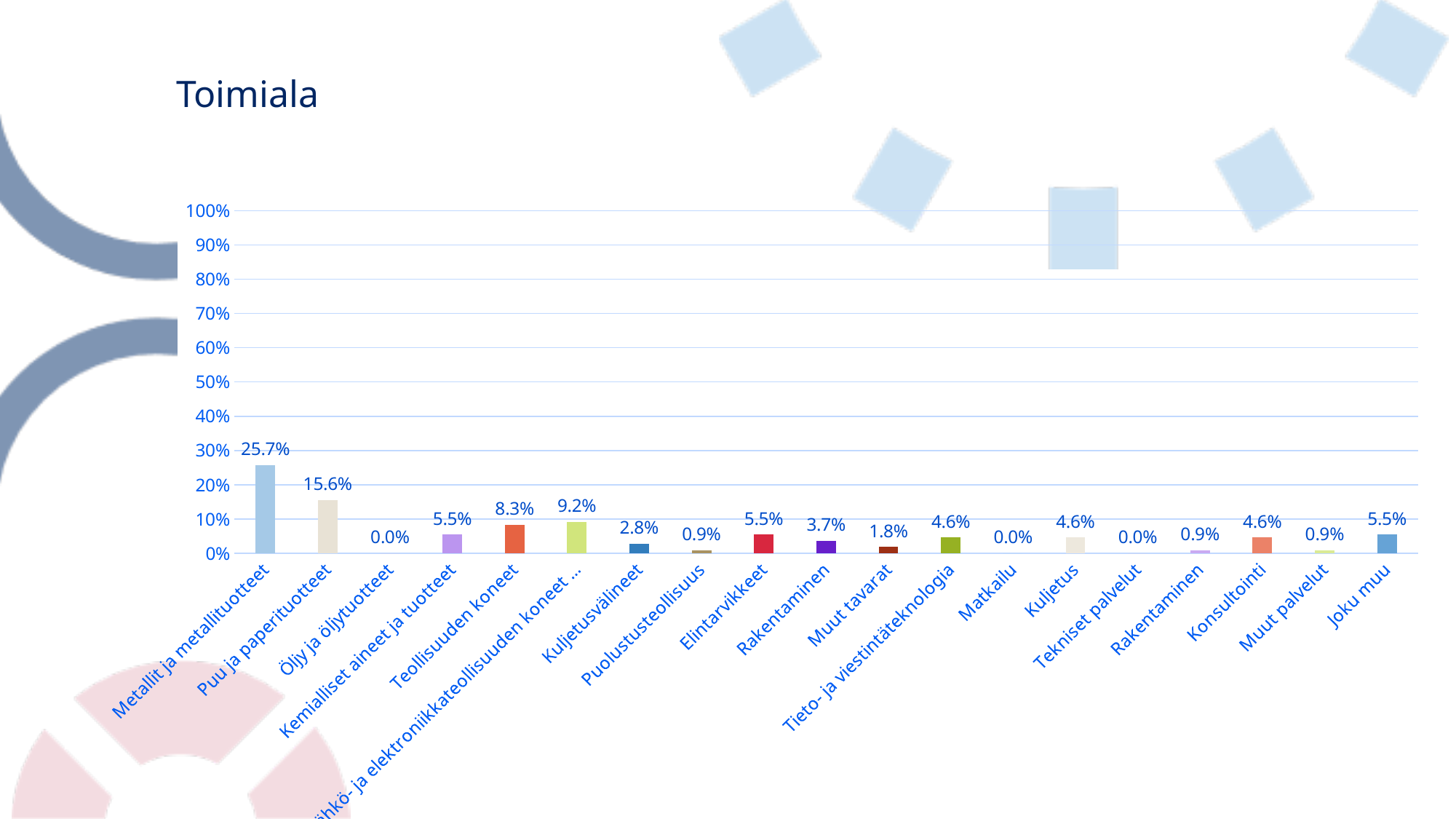
How many categories are shown on the x axis? 19 Which category has the highest value? Metallit ja metallituotteet Is the value for Metallit ja metallituotteet greater or less than 20%? greater What is the value for Joku muu? 5.5% What is the title of the slide? Toimiala What is the value for Teollisuuden koneet? 8.3% What is the value for Puu ja paperituotteet? 15.6% What is the value for Matkailu? 0.0% What is the difference between the values for Metallit ja metallituotteet and Puu ja paperituotteet? 10.1% Which is larger, the value for Teollisuuden koneet or the value for Elintarvikkeet? Teollisuuden koneet What kind of chart is shown on the slide? bar chart What is the value for Kuljetusvälineet? 2.8%